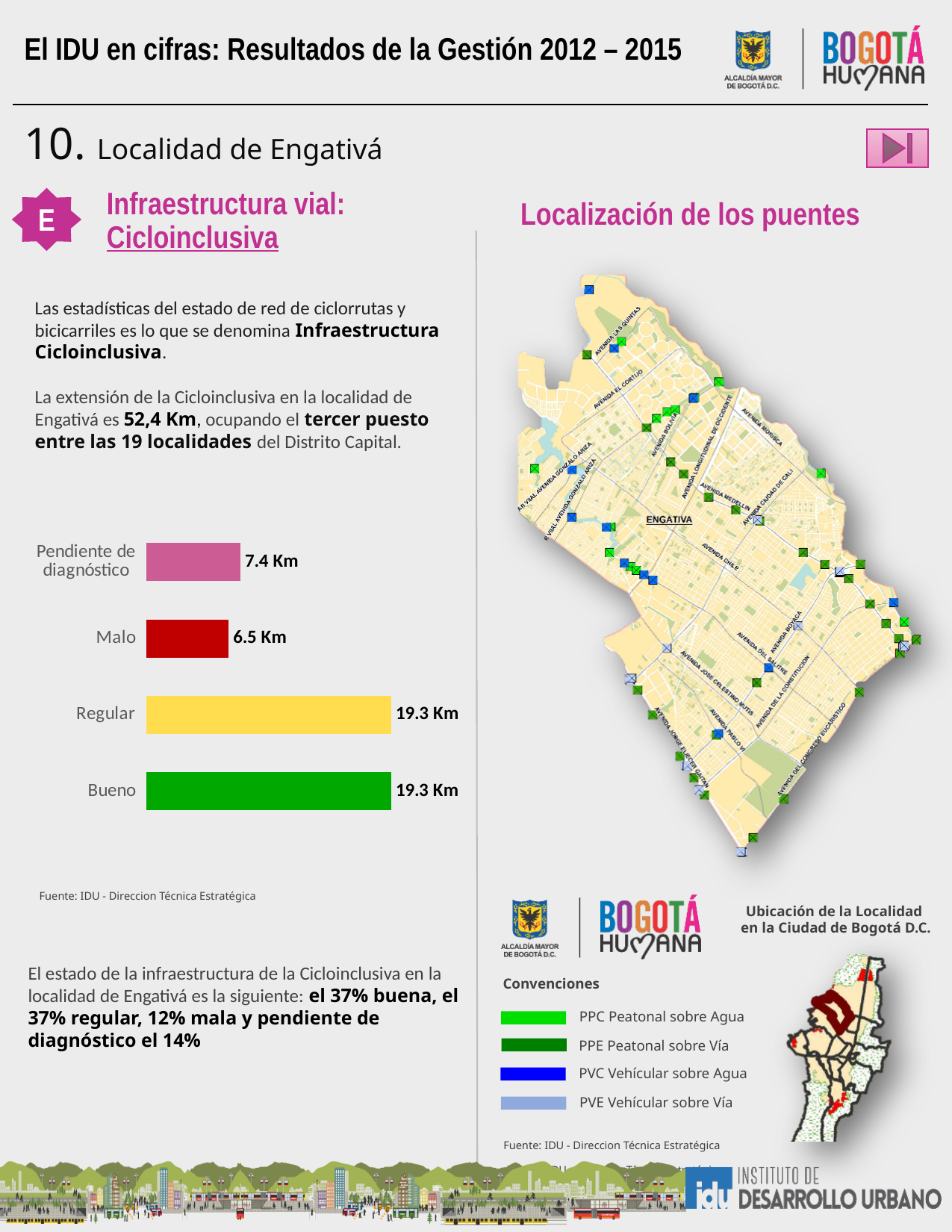
What kind of chart is shown on the left side of the slide under 'Infraestructura vial: Cicloinclusiva'? Bar chart In the bar chart, what is the value for 'Bueno'? 19.3 Km In the bar chart, which category has the lowest value? Malo In the bar chart, what colour is the bar for 'Bueno'? Green In the bar chart, what is the value for 'Malo'? 6.5 Km In the bar chart, what is the value for 'Regular'? 19.3 Km In the bar chart, which is larger: the value for 'Pendiente de diagnóstico' or the value for 'Malo'? Pendiente de diagnóstico In the bar chart, what is the value for 'Pendiente de diagnóstico'? 7.4 Km In the bar chart, what colour is the bar for 'Malo'? Red In the bar chart, what is the difference between the values for 'Regular' and 'Malo'? 12.8 Km In the bar chart, what is the difference between the values for 'Pendiente de diagnóstico' and 'Malo'? 0.9 Km How many categories are shown in the bar chart? 4